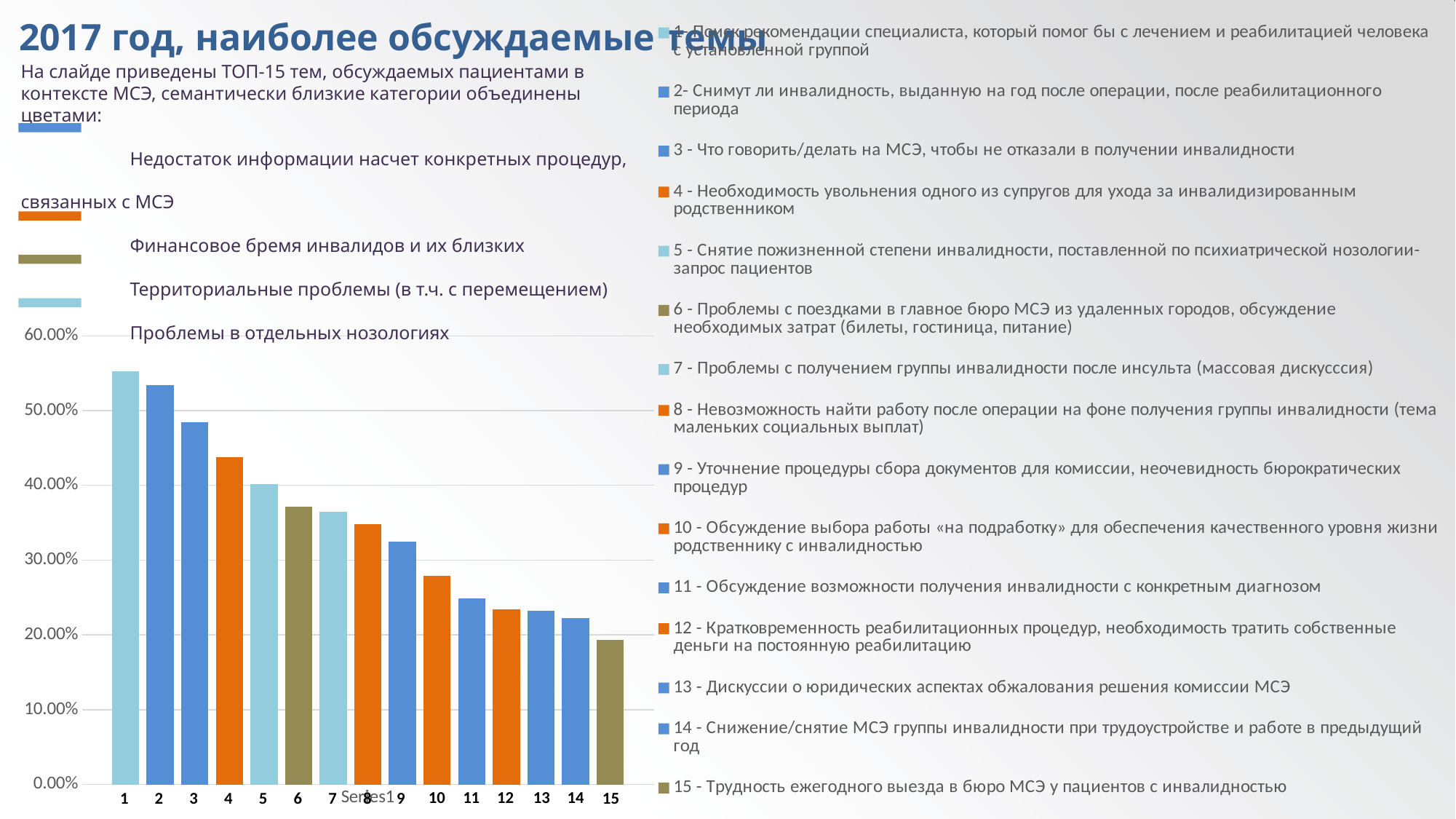
Is the value for category 10 greater or less than 30.00%? less What colour is the bar for category 6? olive (khaki) Which is larger, the value for category 4 or the value for category 8? 4 Is the value for category 1 greater or less than 50.00%? greater Is the value for category 15 greater or less than 20.00%? less Which category has the highest bar on the chart? 1 How many categories (bars) are plotted on the chart? 15 Which category has the lowest bar on the chart? 15 What is the name of the series shown in the chart legend? Series1 What kind of chart is shown on the slide? bar chart Do the bar values rise or fall from category 1 to category 15? fall